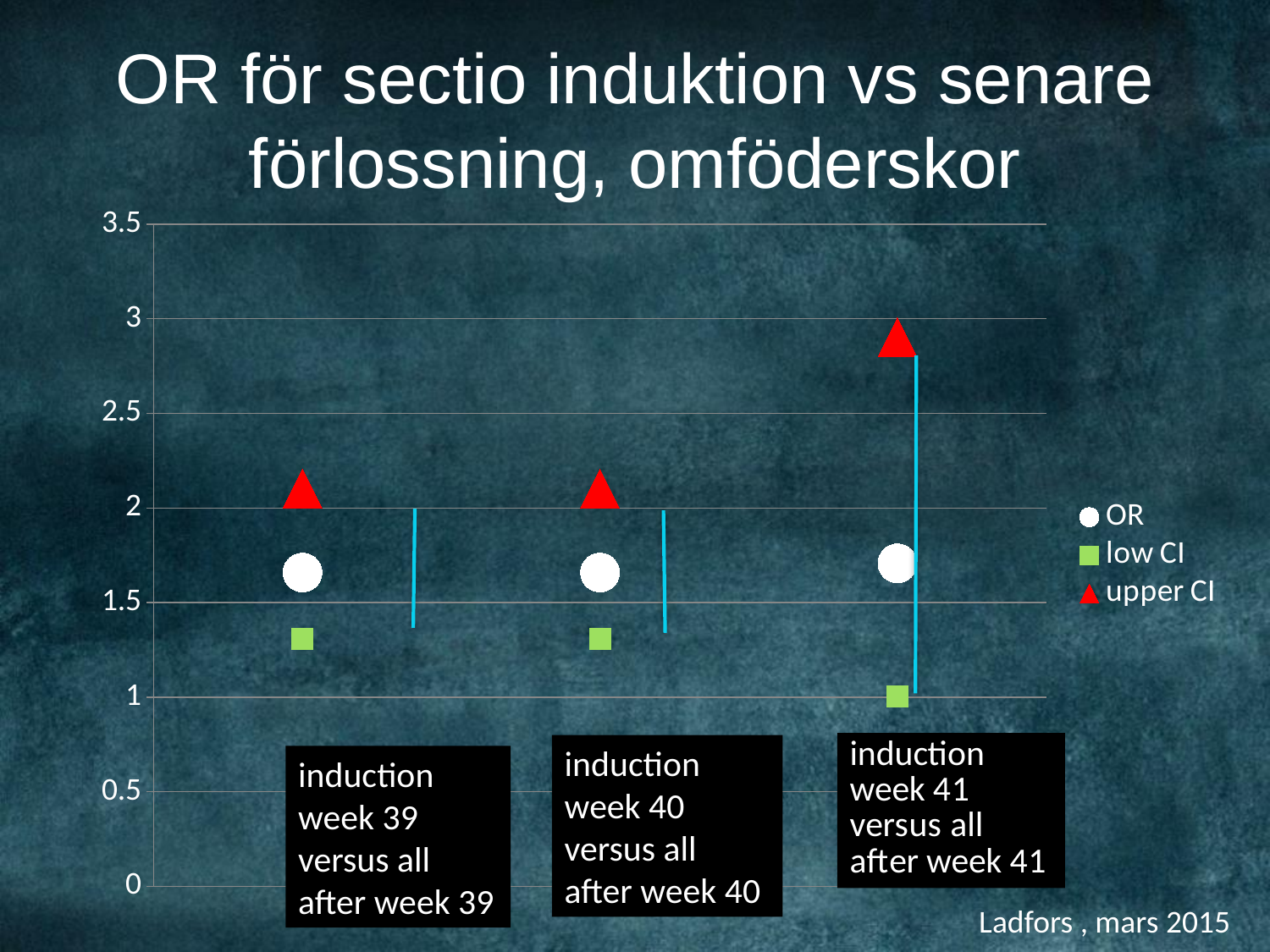
Which category has the lowest low CI value? induction week 41 versus all after week 41 How many series does the legend list? 3 Which is larger, the upper CI for induction week 41 versus all after week 41 or the upper CI for induction week 39 versus all after week 39? induction week 41 versus all after week 41 Is the upper CI value for induction week 41 versus all after week 41 greater or less than 2.5? greater Which is larger, the low CI for induction week 39 versus all after week 39 or the low CI for induction week 41 versus all after week 41? induction week 39 versus all after week 39 What marker shape is used for the upper CI series? red triangle Is the OR value for induction week 40 versus all after week 40 greater or less than 1.5? greater Which category has the highest upper CI value? induction week 41 versus all after week 41 How many categories are plotted on the x axis? 3 Is the upper CI value for induction week 39 versus all after week 39 greater or less than 2.5? less What are the three entries listed in the legend? OR, low CI, upper CI